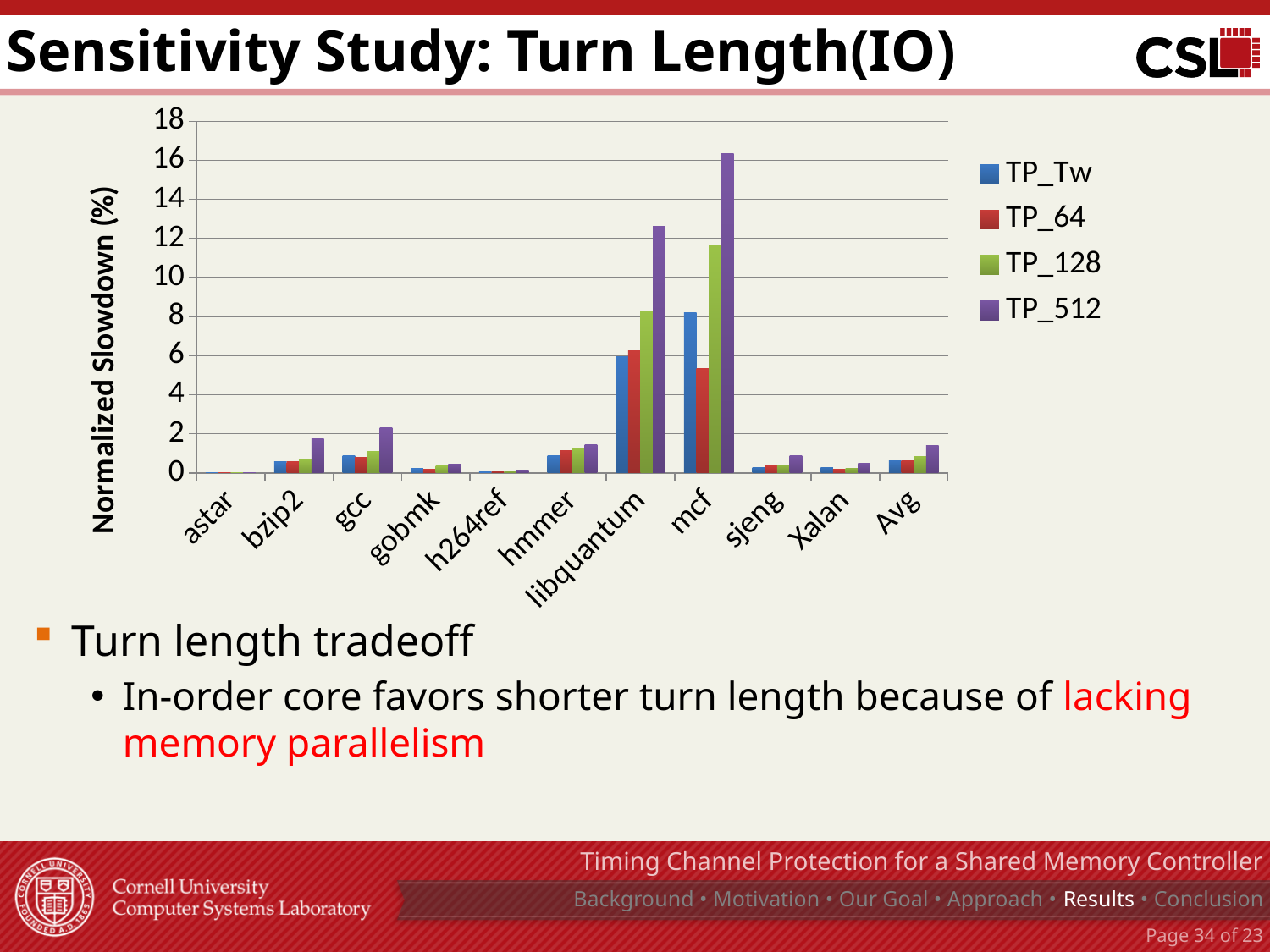
What is the label of the y axis? Normalized Slowdown (%) Is the TP_512 value for libquantum greater or less than 10? greater For mcf, which series has the lowest value? TP_64 Which category has the highest TP_512 value? mcf How many categories are shown on the x axis? 11 Which is larger, the TP_64 value for libquantum or the TP_64 value for mcf? libquantum What kind of chart is shown on the slide? bar chart For libquantum, which series has the highest value? TP_512 Is the TP_512 value for mcf greater or less than 14? greater How many series does the legend list? 4 Which is larger, the TP_Tw value for mcf or the TP_Tw value for libquantum? mcf Is the TP_64 value for mcf greater or less than 6? less